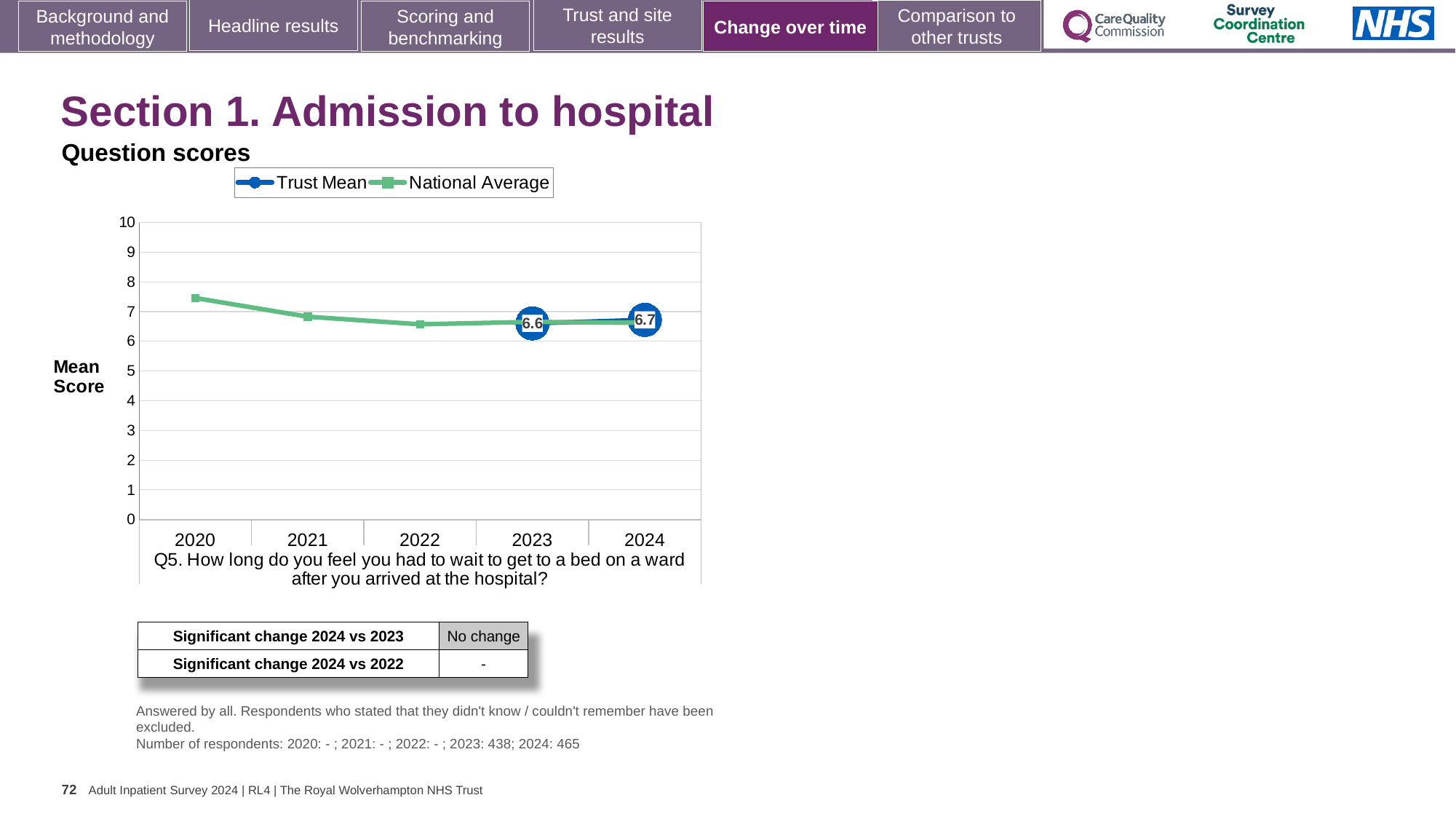
Is the National Average for 2022 greater or less than 7? less What is the Trust Mean score for 2024? 6.7 Which year has the higher Trust Mean score, 2023 or 2024? 2024 By how much did the Trust Mean change from 2023 to 2024? 0.1 What is the label of the y axis on the chart? Mean Score How many series does the chart legend list? 2 Does the National Average rise or fall from 2020 to 2022? fall What type of chart is used to show the question scores? line chart What is the Trust Mean score for 2023? 6.6 How many years are shown on the x axis of the chart? 5 Is the National Average for 2020 greater or less than 7? greater Does the Trust Mean rise or fall from 2023 to 2024? rise